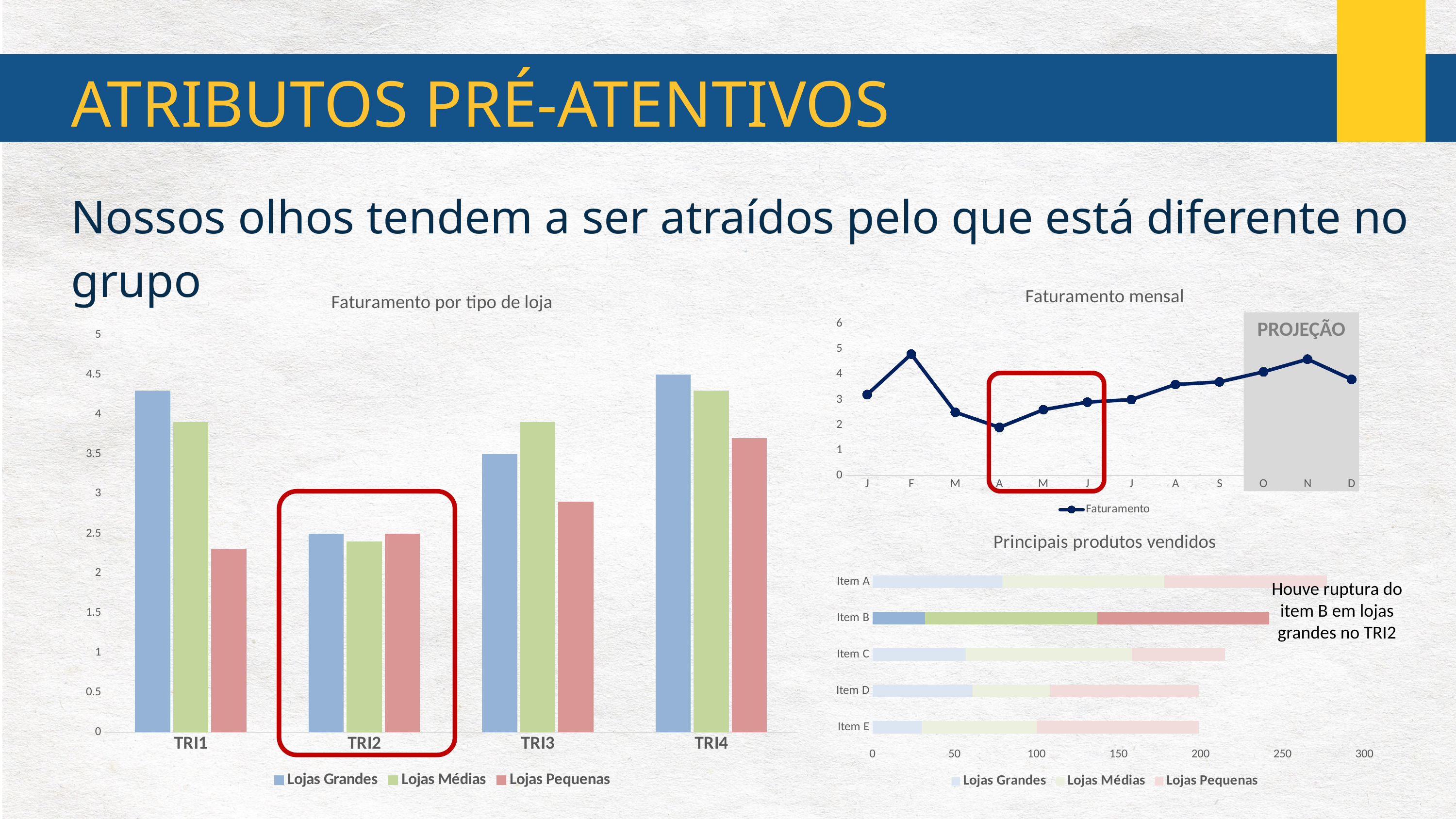
In "Principais produtos vendidos", is the total for Item A greater or less than 150? greater In "Faturamento por tipo de loja", is the value for Lojas Grandes in TRI4 greater or less than 4? greater In "Faturamento por tipo de loja", which quarter has the lowest value for Lojas Médias? TRI2 In "Faturamento mensal", which month has the highest value? F In "Faturamento mensal", which month has the lowest value? A What type of chart is "Faturamento mensal"? line chart How many series does the legend of "Faturamento por tipo de loja" list? 3 How many quarters are shown on the x axis of "Faturamento por tipo de loja"? 4 What type of chart is "Faturamento por tipo de loja"? bar chart In "Principais produtos vendidos", which item has the longest total bar? Item A In "Faturamento por tipo de loja", is the value for Lojas Grandes in TRI2 greater or less than 3? less